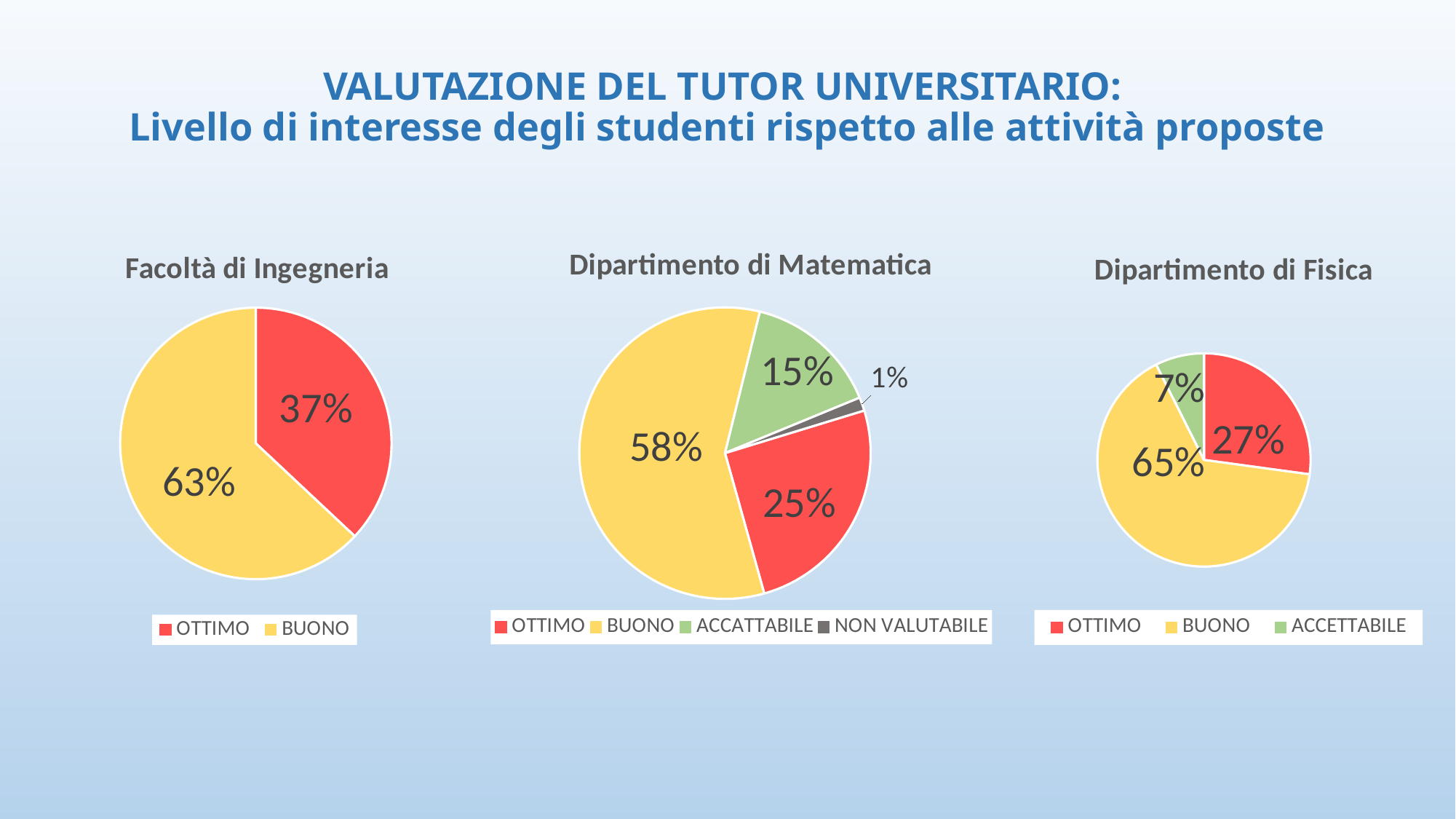
In the 'Dipartimento di Matematica' chart, what percentage is labelled for ACCATTABILE? 15% In the 'Dipartimento di Matematica' chart, which is larger, OTTIMO or ACCATTABILE? OTTIMO In the 'Dipartimento di Fisica' chart, which category has the smallest slice? ACCETTABILE In the 'Facoltà di Ingegneria' chart, what is the difference between the BUONO and OTTIMO percentages? 26% In the 'Dipartimento di Matematica' chart, which category has the largest slice? BUONO In the 'Facoltà di Ingegneria' chart, what percentage is labelled for BUONO? 63% In the 'Facoltà di Ingegneria' chart, what percentage is labelled for OTTIMO? 37% In the 'Dipartimento di Matematica' chart, what percentage is labelled for NON VALUTABILE? 1% What kind of chart is the 'Dipartimento di Fisica' chart? Pie chart How many categories does the legend of the 'Dipartimento di Matematica' chart list? 4 In the 'Dipartimento di Fisica' chart, what percentage is labelled for OTTIMO? 27% In the 'Dipartimento di Fisica' chart, what colour is the BUONO slice? Yellow